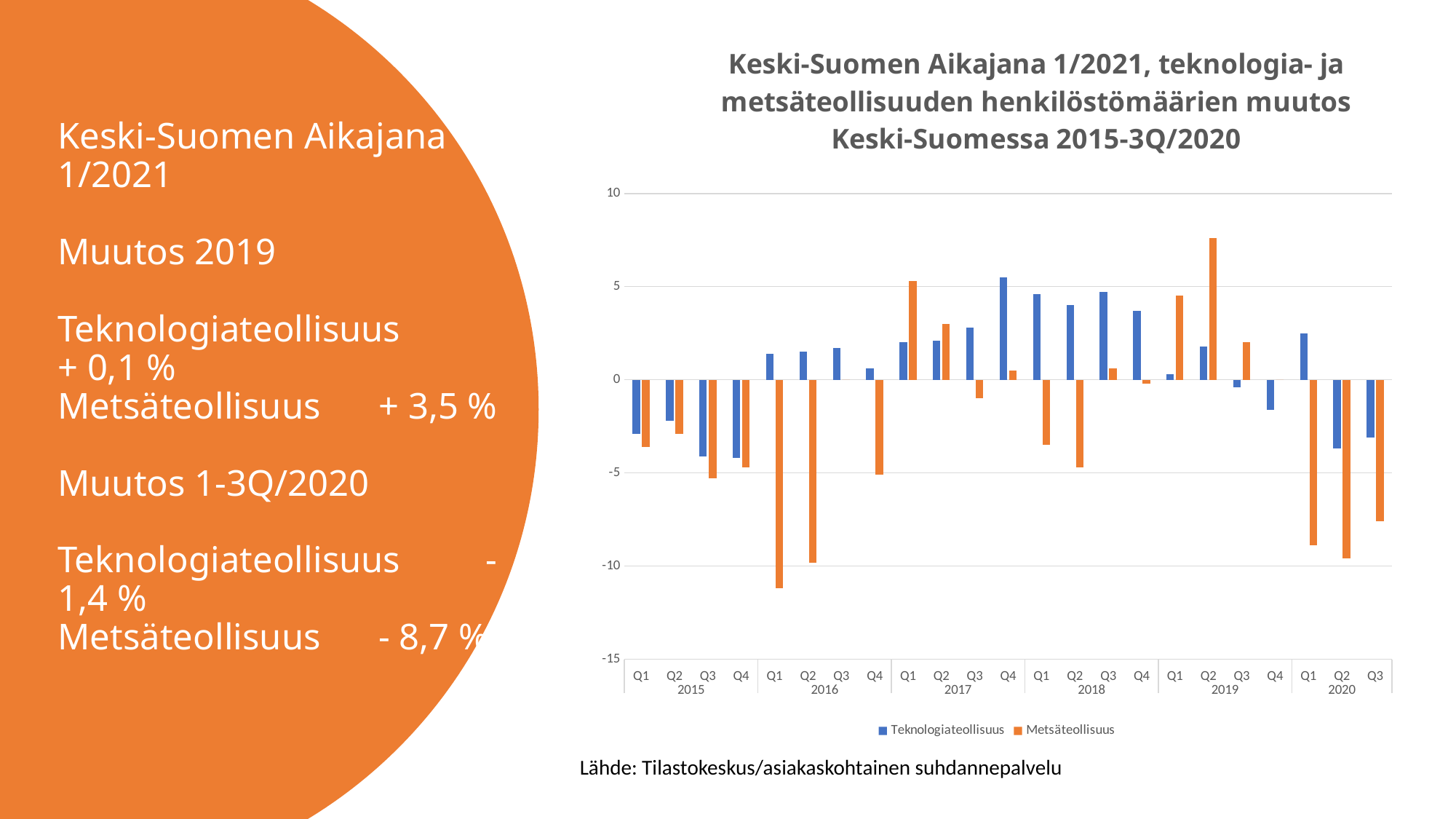
In Q2 2020, which series has the larger value, Teknologiateollisuus or Metsäteollisuus? Teknologiateollisuus Is the value for Metsäteollisuus in Q2 2019 greater or less than 5? greater In which quarter does Metsäteollisuus reach its lowest value? Q1 2016 In which quarter does Teknologiateollisuus reach its highest value? Q4 2017 What kind of chart is shown on the slide? Bar chart In which quarter does Metsäteollisuus reach its highest value? Q2 2019 How many quarters are plotted along the x axis of the chart? 23 How many series does the chart legend list? 2 Is the value for Metsäteollisuus in Q1 2020 greater or less than -5? less In Q1 2017, which series has the larger value, Teknologiateollisuus or Metsäteollisuus? Metsäteollisuus Which colour represents Metsäteollisuus in the chart? Orange Is the value for Metsäteollisuus in Q1 2016 greater or less than -10? less